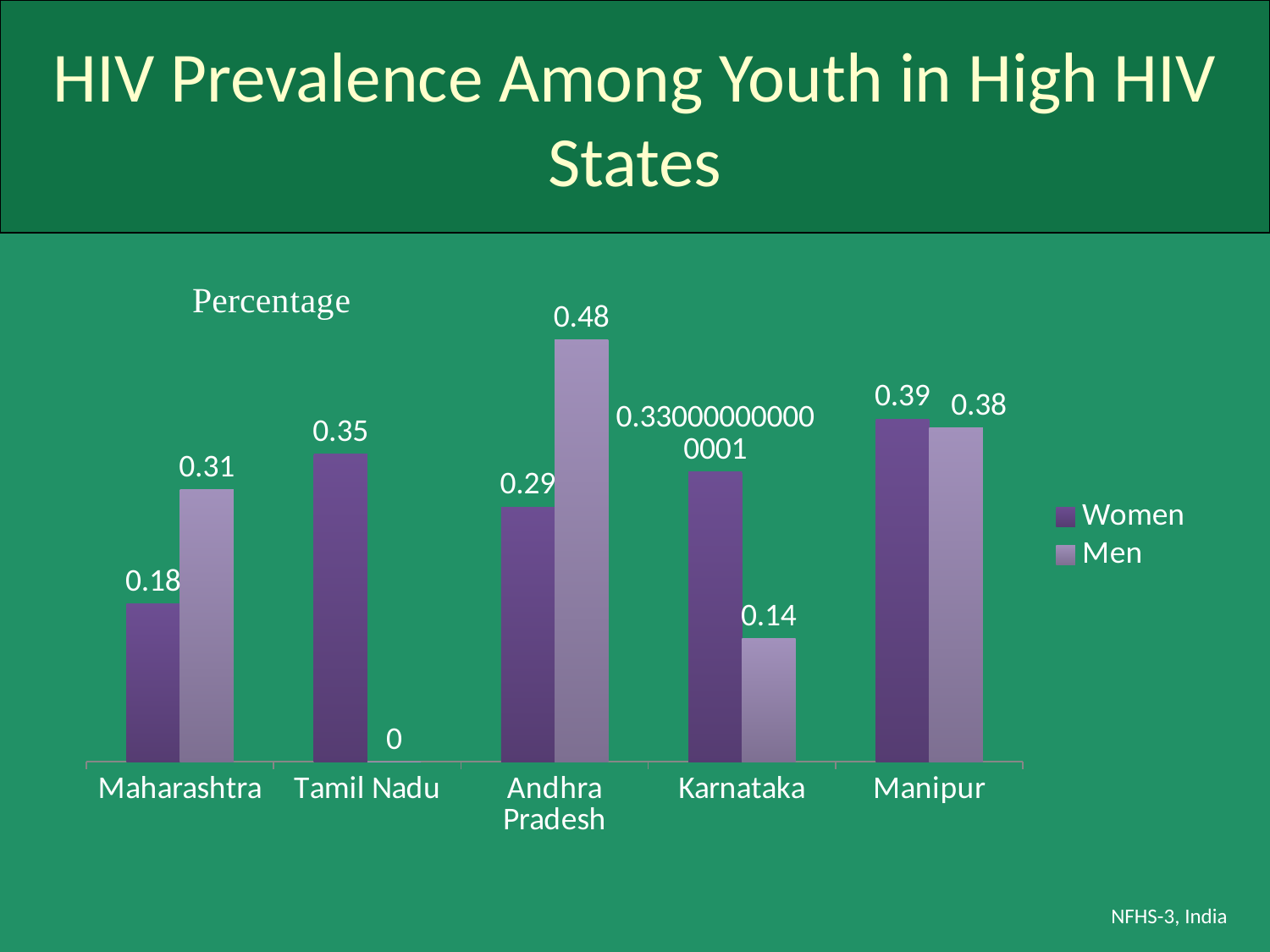
Which state has the highest value for Men? Andhra Pradesh What is the value for Men in Andhra Pradesh? 0.48 What is the value for Women in Tamil Nadu? 0.35 In Maharashtra, which is larger, the value for Women or for Men? Men How many states are shown on the x axis? 5 What is the value for Men in Karnataka? 0.14 Which state has the lowest value for Men? Tamil Nadu What is the value for Women in Manipur? 0.39 How many series does the legend list? 2 Which state has the lowest value for Women? Maharashtra What is the value for Men in Maharashtra? 0.31 In Andhra Pradesh, how much higher is the value for Men than for Women? 0.19